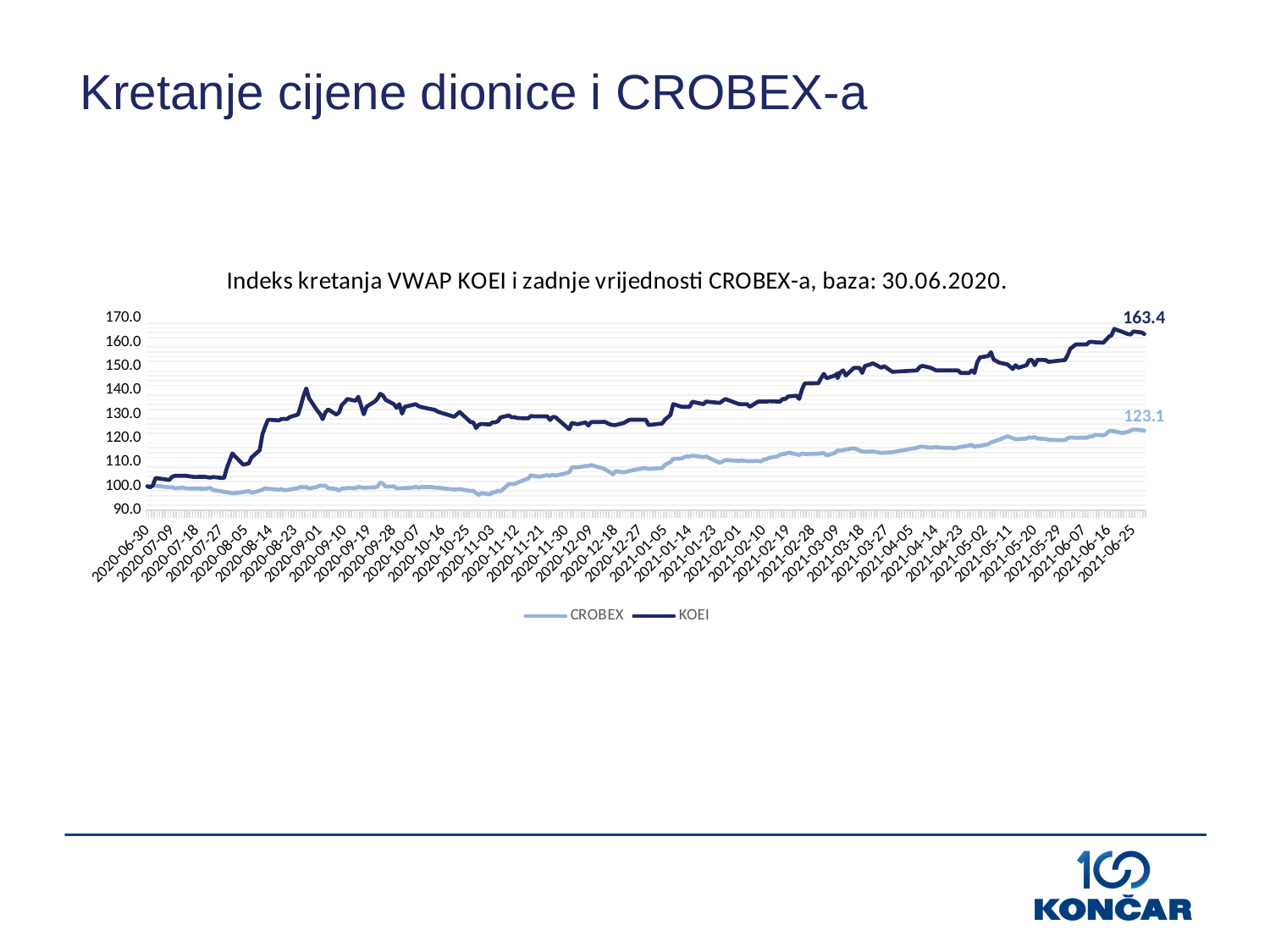
What is the final value shown for the CROBEX series? 123.1 How many series does the legend list? 2 What is the difference between the final KOEI value and the final CROBEX value? 40.3 Do the values of the KOEI series generally rise or fall from 2020-06-30 to 2021-06-25? Rise What is the final value shown for the KOEI series? 163.4 Which series ends at a higher value, KOEI or CROBEX? KOEI Is the value of the KOEI series at 2021-03-27 greater or less than 140.0? greater What kind of chart is shown on the slide? Line chart Which series is drawn with the darker blue line? KOEI Is the value of the CROBEX series at 2020-11-03 greater or less than 100.0? less Is the value of the CROBEX series at 2020-12-09 greater or less than 100.0? greater What is the title of the chart? Indeks kretanja VWAP KOEI i zadnje vrijednosti CROBEX-a, baza: 30.06.2020.